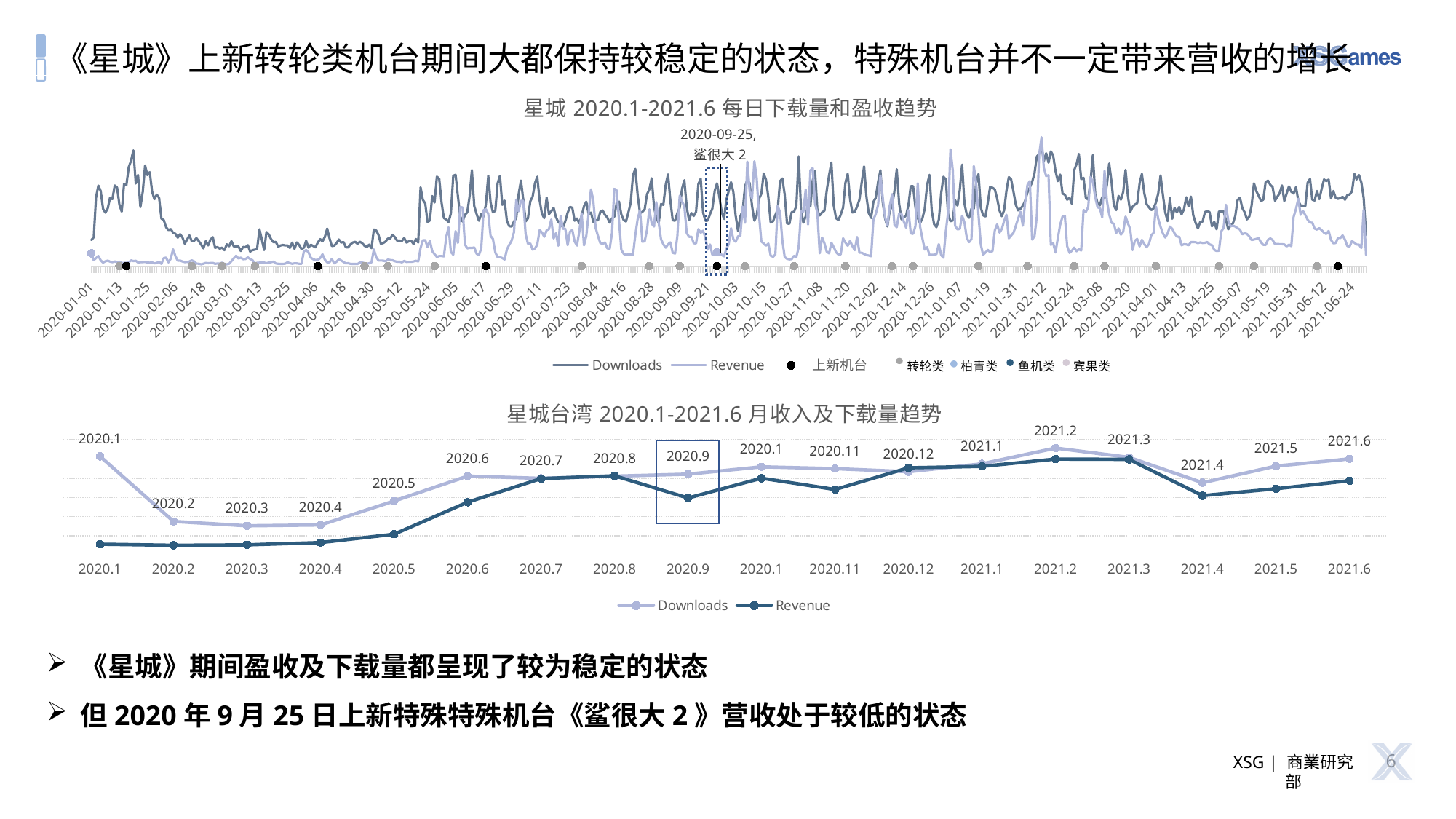
In the bottom chart (星城台湾 2020.1-2021.6 月收入及下载量趋势), does Downloads rise or fall from 2020.1 to 2020.3? fall In the bottom chart (星城台湾 2020.1-2021.6 月收入及下载量趋势), is Downloads higher in 2021.3 or in 2021.4? 2021.3 In the bottom chart (星城台湾 2020.1-2021.6 月收入及下载量趋势), is Downloads higher in 2020.1 or in 2020.2? 2020.1 In the bottom chart (星城台湾 2020.1-2021.6 月收入及下载量趋势), in which month is Downloads highest? 2021.2 What kind of chart is the bottom chart titled 星城台湾 2020.1-2021.6 月收入及下载量趋势? line chart What kind of chart is the top chart titled 星城 2020.1-2021.6 每日下载量和盈收趋势? line chart In the top chart (星城 2020.1-2021.6 每日下载量和盈收趋势), what date is marked by the annotation for 鲨很大 2? 2020-09-25 In the bottom chart (星城台湾 2020.1-2021.6 月收入及下载量趋势), is Revenue higher in 2020.8 or in 2020.9? 2020.8 In the bottom chart (星城台湾 2020.1-2021.6 月收入及下载量趋势), how many series does the legend list? 2 In the top chart (星城 2020.1-2021.6 每日下载量和盈收趋势), which legend entry is shown with black dots? 上新机台 In the bottom chart (星城台湾 2020.1-2021.6 月收入及下载量趋势), how many months are plotted along the x axis? 18 In the bottom chart (星城台湾 2020.1-2021.6 月收入及下载量趋势), does Revenue rise or fall from 2020.4 to 2020.7? rise